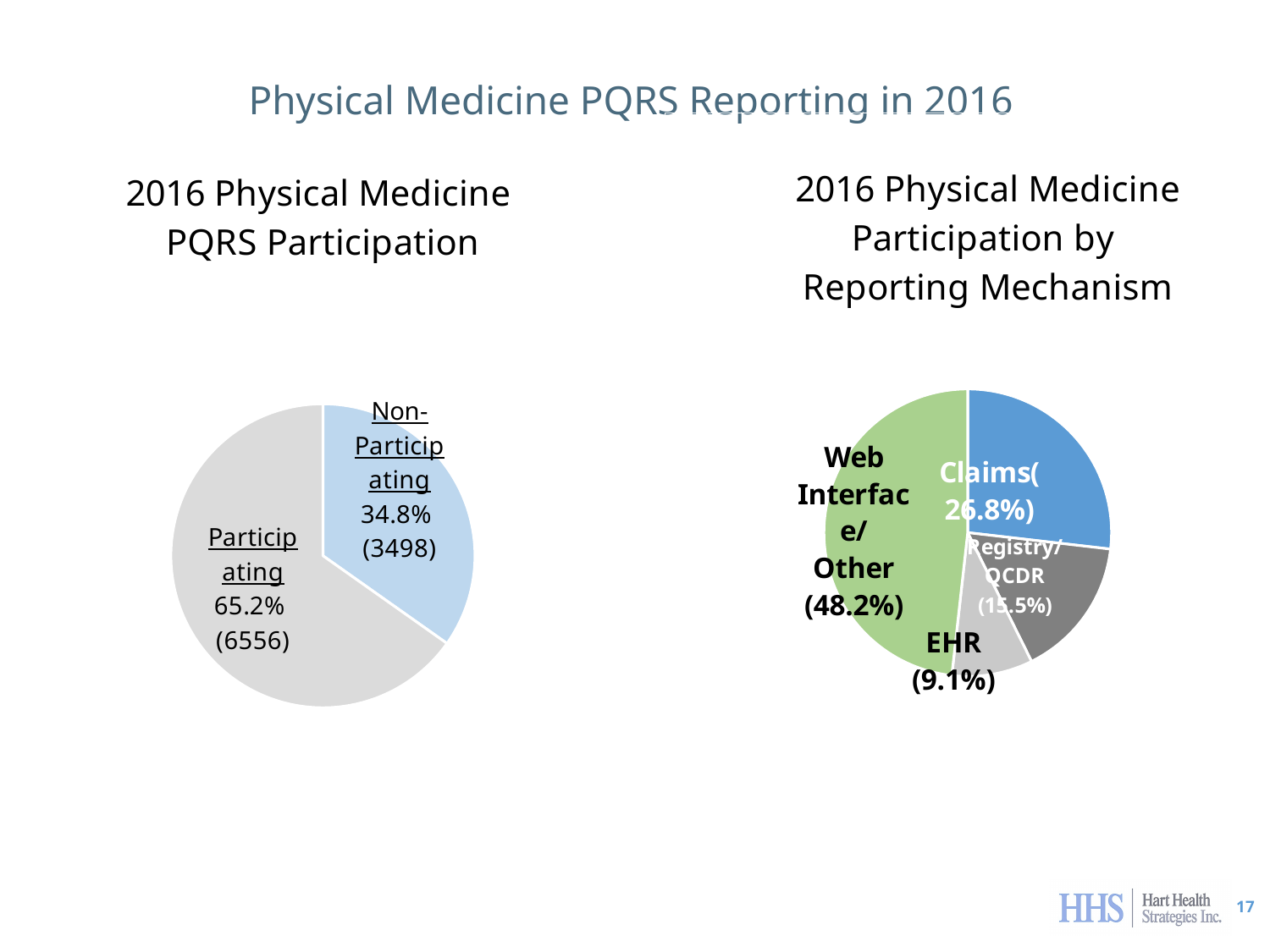
In the '2016 Physical Medicine Participation by Reporting Mechanism' chart, what share is EHR? 9.1% In the '2016 Physical Medicine Participation by Reporting Mechanism' chart, which is larger, Claims or Registry/QCDR? Claims In the '2016 Physical Medicine PQRS Participation' chart, what is the difference in count between participating and non-participating physicians? 3058 In the '2016 Physical Medicine Participation by Reporting Mechanism' chart, which reporting mechanism has the smallest share? EHR In the '2016 Physical Medicine PQRS Participation' chart, what share of physicians were participating? 65.2% In the '2016 Physical Medicine Participation by Reporting Mechanism' chart, how many reporting mechanisms are shown? 4 In the '2016 Physical Medicine Participation by Reporting Mechanism' chart, which reporting mechanism has the largest share? Web Interface/Other In the '2016 Physical Medicine PQRS Participation' chart, how many physicians were participating? 6556 What kind of chart is the '2016 Physical Medicine PQRS Participation' chart? Pie chart In the '2016 Physical Medicine PQRS Participation' chart, how many physicians were non-participating? 3498 In the '2016 Physical Medicine Participation by Reporting Mechanism' chart, what share is Claims? 26.8% In the '2016 Physical Medicine Participation by Reporting Mechanism' chart, what colour is the Web Interface/Other slice? Green